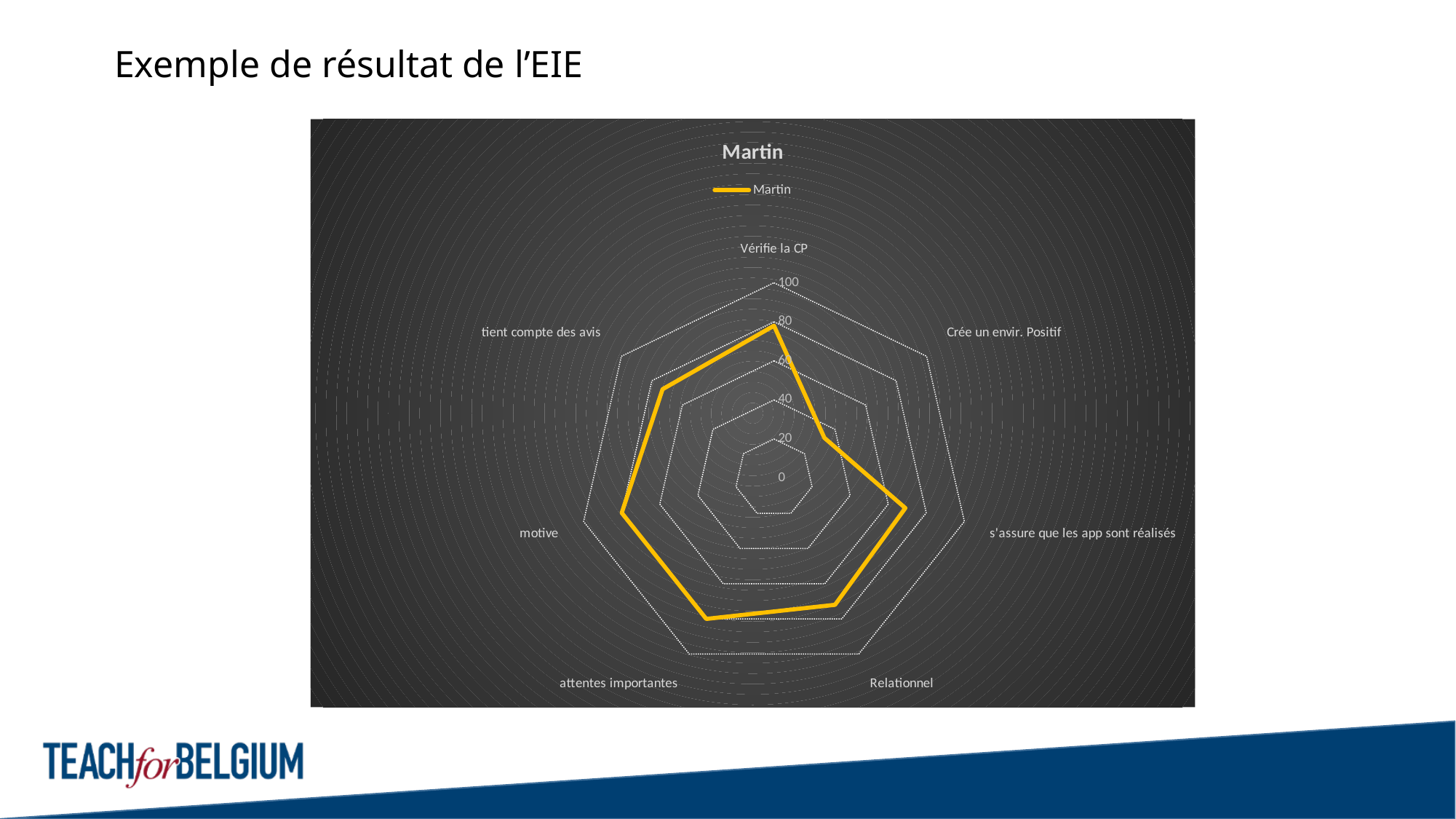
Is the value for motive greater or less than 60? greater What kind of chart is shown on the slide? Radar chart Which is larger, the value for motive or the value for tient compte des avis? motive Which is larger, the value for Vérifie la CP or the value for Crée un envir. Positif? Vérifie la CP Is the value for Crée un envir. Positif greater or less than 60? less How many categories (axes) does the radar chart have? 7 What is the title of the chart? Martin Is the value for Vérifie la CP greater or less than 60? greater Which category has the lowest value for Martin? Crée un envir. Positif What is the highest value shown on the radar chart's scale? 100 How many series does the legend list? 1